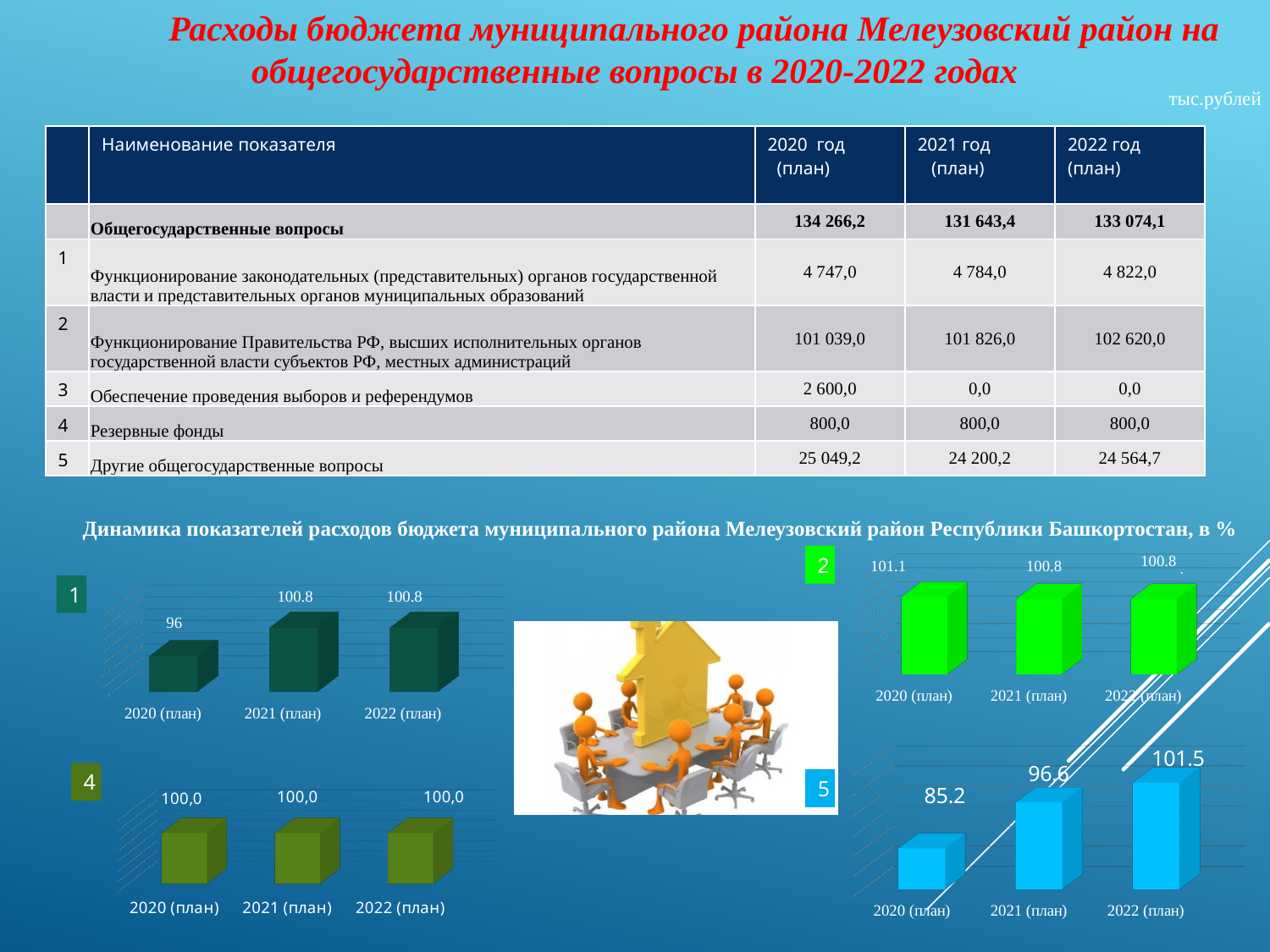
In the chart labelled 5 (bottom-right), what is the difference between the 2022 (план) and 2020 (план) values? 16.3 In the chart labelled 1 (top-left), what is the difference between the 2021 (план) and 2020 (план) values? 4.8 In the chart labelled 1 (top-left), which year has the lowest value? 2020 (план) In the chart labelled 4 (bottom-left), what is the value for 2022 (план)? 100,0 In the chart labelled 5 (bottom-right), what is the value for 2022 (план)? 101.5 How many bars does the chart labelled 5 (bottom-right) show? 3 In the chart labelled 2 (top-right), which year has the highest value? 2020 (план) In the chart labelled 1 (top-left), what is the value for 2021 (план)? 100.8 In the chart labelled 5 (bottom-right), do the values rise or fall from 2020 (план) to 2022 (план)? rise In the chart labelled 1 (top-left), what is the value for 2020 (план)? 96 In the chart labelled 5 (bottom-right), what is the value for 2020 (план)? 85.2 In the chart labelled 2 (top-right), what is the value for 2020 (план)? 101.1